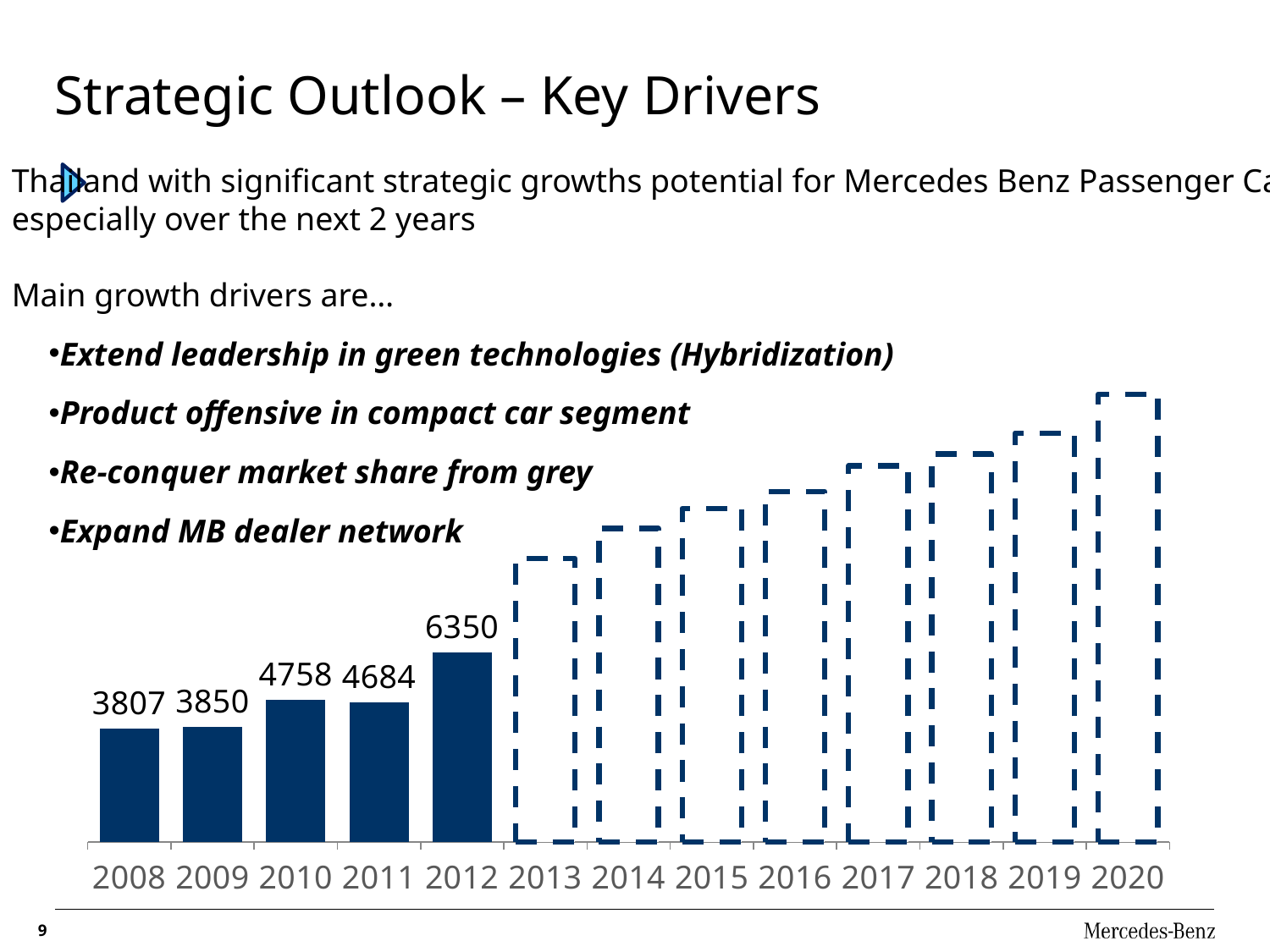
How many years are shown on the x axis of the chart? 13 What kind of chart is shown on the slide? bar chart What is the difference between the values for 2010 and 2008? 951 What is the value shown for 2010? 4758 Which is larger, the value for 2010 or the value for 2011? 2010 What is the value shown for 2008? 3807 Do the dashed bars from 2013 to 2020 rise or fall along the x axis? rise Among the years with printed values, which year has the lowest value? 2008 What is the difference between the values for 2012 and 2011? 1666 Among the years with printed values, which year has the highest value? 2012 What is the value shown for 2012? 6350 What is the value shown for 2011? 4684